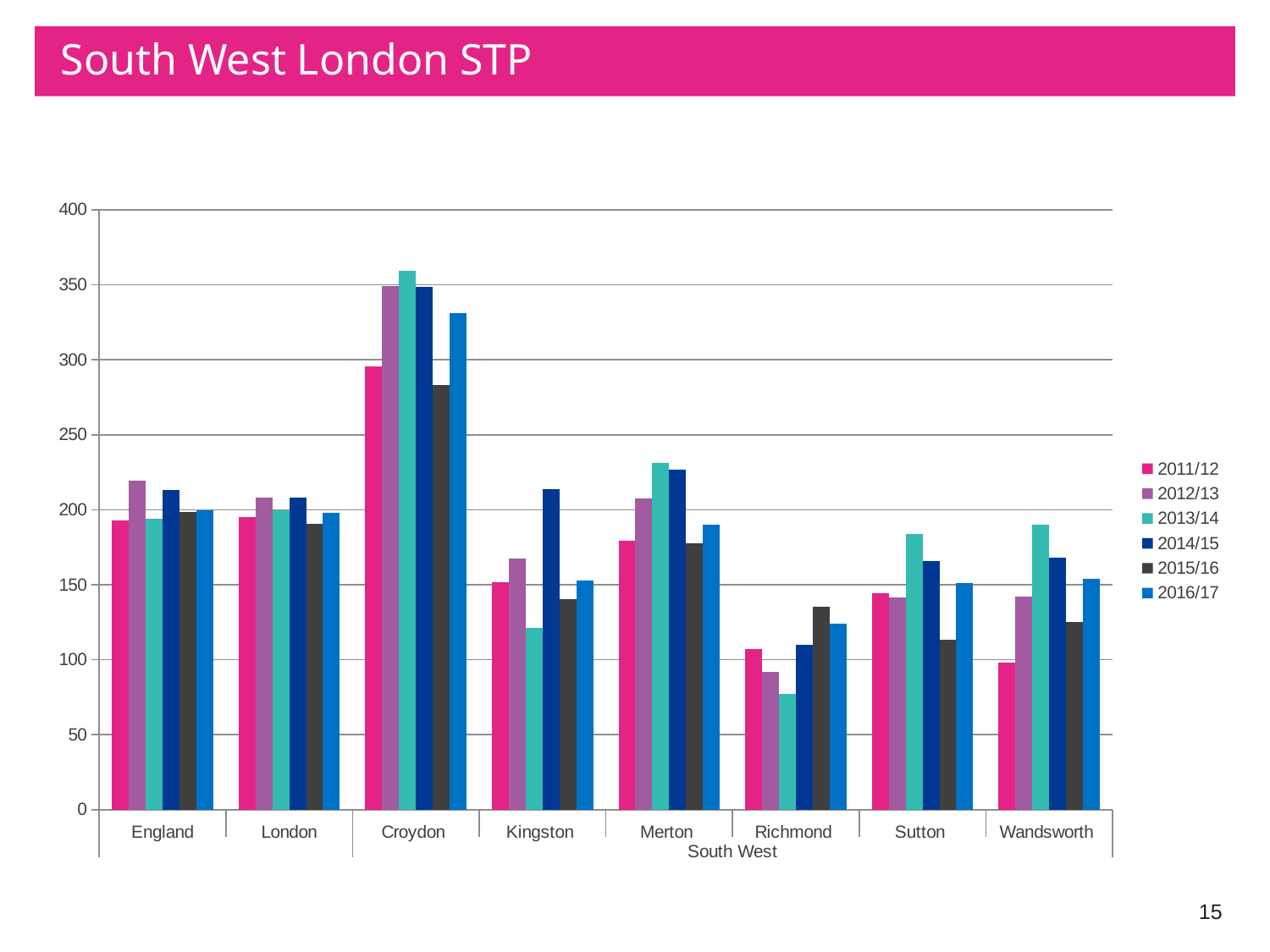
Is the value for Croydon in 2013/14 greater or less than 350? greater What is the group label shown beneath the borough categories on the x axis? South West Is the value for Richmond in 2013/14 greater or less than 100? less Do the values for Richmond rise or fall from 2011/12 to 2013/14? fall Is the value for Kingston in 2014/15 greater or less than 200? greater Which is larger, the 2013/14 value for Croydon or the 2013/14 value for Merton? Croydon How many categories are shown along the x axis? 8 What kind of chart is shown on the slide? bar chart Which category has the highest bars overall? Croydon Which category has the lowest single bar on the chart? Richmond How many series does the legend list? 6